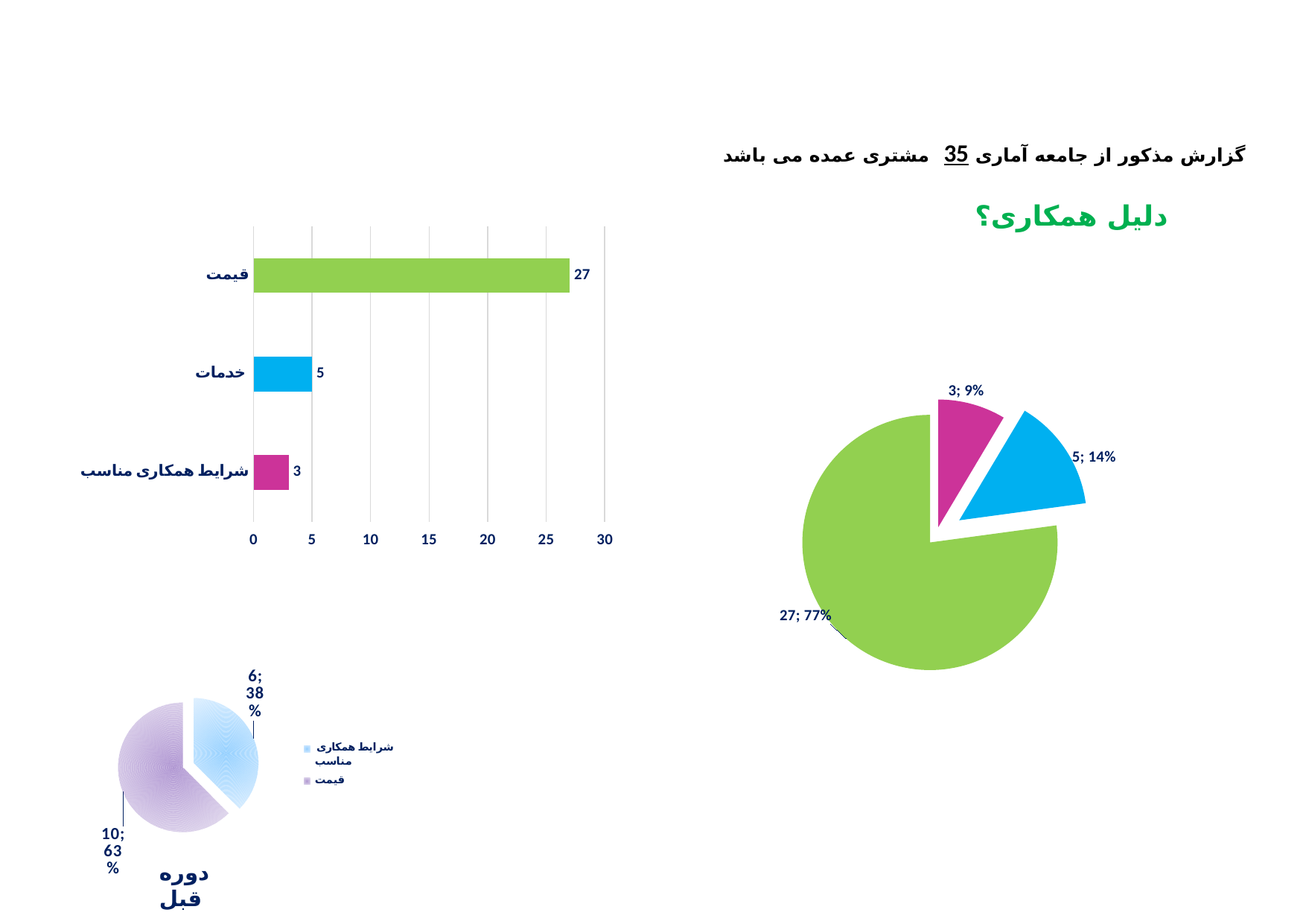
In the large pie chart on the right, what share does the largest slice represent? 77% In the bar chart at the top left, how many categories are shown? 3 In the small pie chart at the bottom left (دوره قبل), what share does قیمت represent? 63% What kind of chart is the chart at the top left of the slide? bar chart In the bar chart at the top left, what is the difference between the values for قیمت and خدمات? 22 In the bar chart at the top left, what is the value for خدمات? 5 In the bar chart at the top left, which category has the highest value? قیمت In the bar chart at the top left, what is the value for شرایط همکاری مناسب? 3 In the bar chart at the top left, which category has the lowest value? شرایط همکاری مناسب In the bar chart at the top left, what is the value for قیمت? 27 In the small pie chart at the bottom left (دوره قبل), how many entries does the legend list? 2 In the large pie chart on the right, what is the value and share of the blue slice? 5; 14%